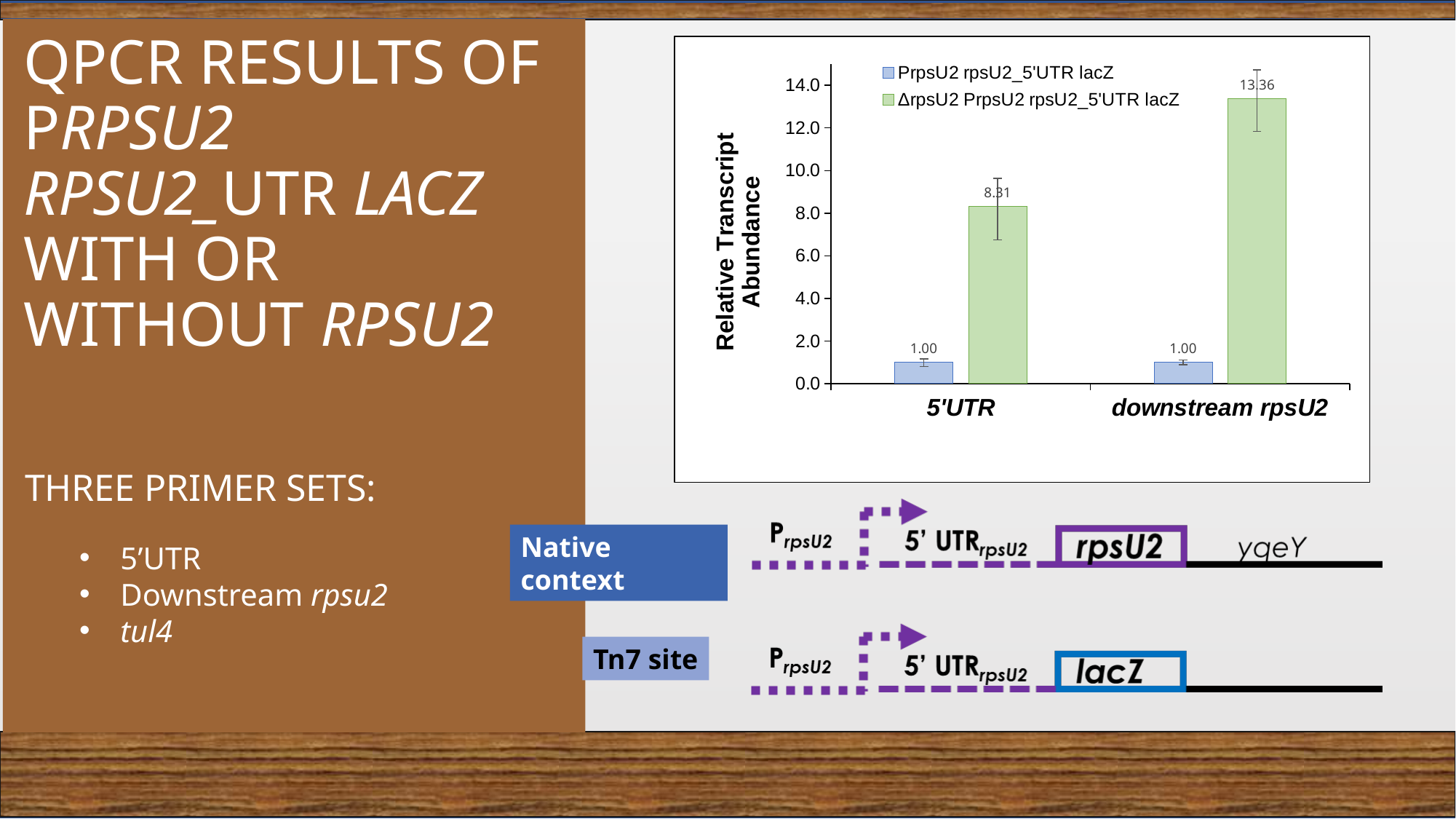
What kind of chart is shown on the slide? bar chart Which category has the highest value for the ΔrpsU2 PrpsU2 rpsU2_5'UTR lacZ series? downstream rpsU2 What is the relative transcript abundance for the ΔrpsU2 PrpsU2 rpsU2_5'UTR lacZ series at 5'UTR? 8.31 At downstream rpsU2, what is the difference between the ΔrpsU2 PrpsU2 rpsU2_5'UTR lacZ value and the PrpsU2 rpsU2_5'UTR lacZ value? 12.36 Is the ΔrpsU2 PrpsU2 rpsU2_5'UTR lacZ value at downstream rpsU2 greater or less than 12.0? greater What is the difference between the ΔrpsU2 PrpsU2 rpsU2_5'UTR lacZ values at downstream rpsU2 and at 5'UTR? 5.05 What is the label of the y axis of the chart? Relative Transcript Abundance How many categories are shown on the x axis of the chart? 2 At 5'UTR, which series has the larger value: PrpsU2 rpsU2_5'UTR lacZ or ΔrpsU2 PrpsU2 rpsU2_5'UTR lacZ? ΔrpsU2 PrpsU2 rpsU2_5'UTR lacZ How many series does the chart legend list? 2 What is the relative transcript abundance for the PrpsU2 rpsU2_5'UTR lacZ series at 5'UTR? 1.00 What is the relative transcript abundance for the ΔrpsU2 PrpsU2 rpsU2_5'UTR lacZ series at downstream rpsU2? 13.36